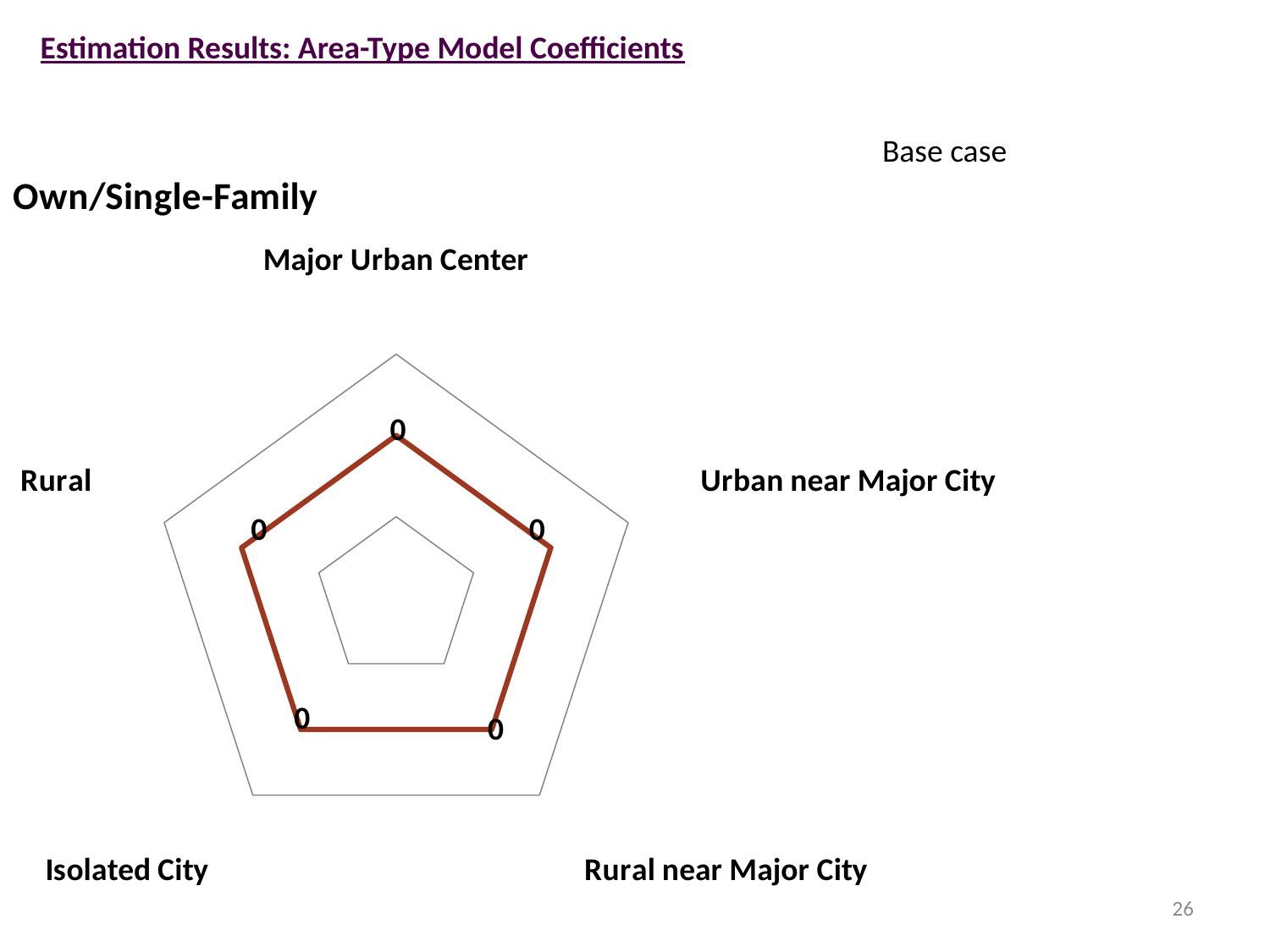
What label appears above the chart to the right, describing the scenario shown? Base case What is the value plotted for Rural? 0 How many categories (axes) does the radar chart have? 5 What kind of chart is shown on the slide? Radar chart What is the difference between the values for Rural and Isolated City? 0 What is the title of the chart? Own/Single-Family What is the value plotted for Major Urban Center? 0 What is the value plotted for Urban near Major City? 0 What is the value plotted for Isolated City? 0 Are the values for Major Urban Center and Urban near Major City equal? Yes What is the value plotted for Rural near Major City? 0